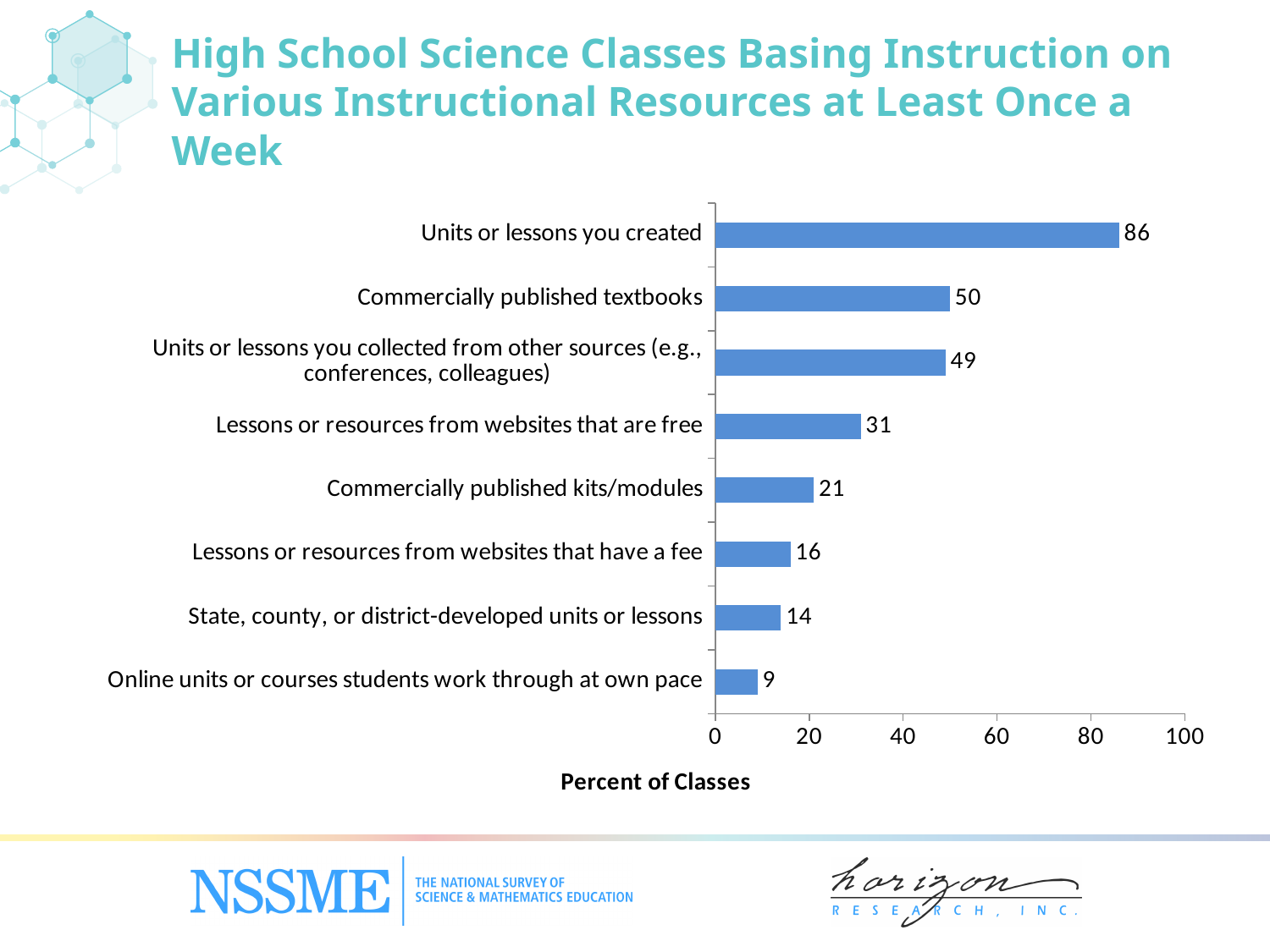
What kind of chart is shown on the slide? Bar chart What is the difference between the values for lessons or resources from websites that are free and commercially published kits/modules? 10 Which instructional resource has the lowest percent of classes? Online units or courses students work through at own pace What is the value for lessons or resources from websites that have a fee? 16 What percent of classes base instruction on units or lessons you created at least once a week? 86 What is the label of the horizontal axis? Percent of Classes Is the value for lessons or resources from websites that are free greater or less than 40? less Which instructional resource has the highest percent of classes? Units or lessons you created Which is larger: the value for commercially published kits/modules or the value for state, county, or district-developed units or lessons? Commercially published kits/modules How many instructional resource categories are shown in the chart? 8 What is the value for commercially published textbooks? 50 What is the difference between the values for units or lessons you created and commercially published textbooks? 36